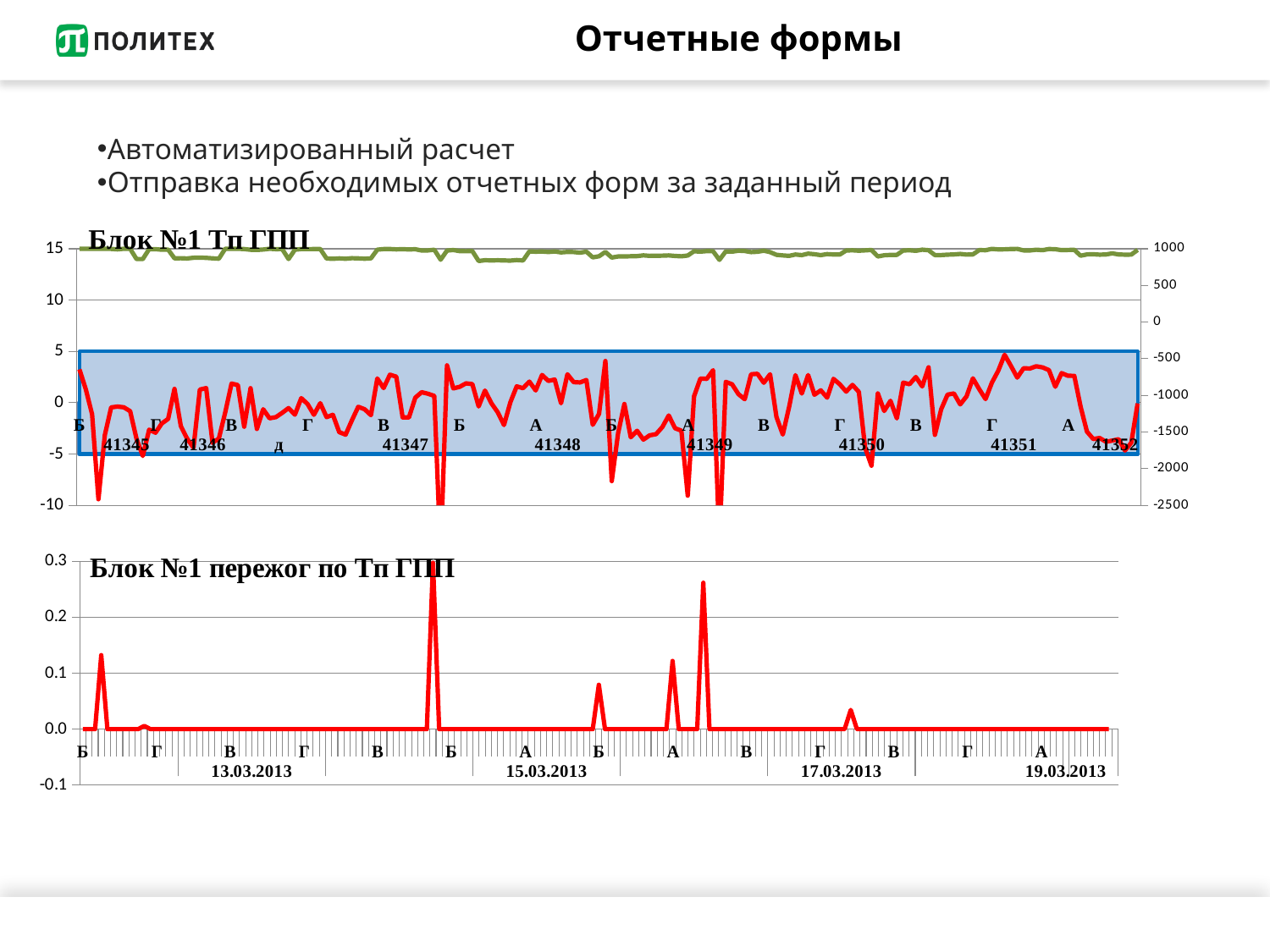
What kind of chart is the bottom chart titled "Блок №1 пережог по Тп ГПП"? line chart What is the title of the bottom chart on the slide? Блок №1 пережог по Тп ГПП On the bottom chart "Блок №1 пережог по Тп ГПП", how many date labels are shown on the x axis? 4 On the top chart "Блок №1 Тп ГПП", how many lines are plotted? 2 On the bottom chart "Блок №1 пережог по Тп ГПП", is the first peak of the red line (just after the 13.03.2013 start) greater or less than 0.1? greater On the bottom chart "Блок №1 пережог по Тп ГПП", is the value of the red line at the 17.03.2013 tick greater or less than 0.1? less On the top chart "Блок №1 Тп ГПП", is the green line greater or less than 500 on the right-hand axis throughout the period? greater What is the title of the top chart on the slide? Блок №1 Тп ГПП What kind of chart is the top chart titled "Блок №1 Тп ГПП"? line chart On the top chart "Блок №1 Тп ГПП", how many numeric day labels (41345 to 41352) are shown along the x axis? 8